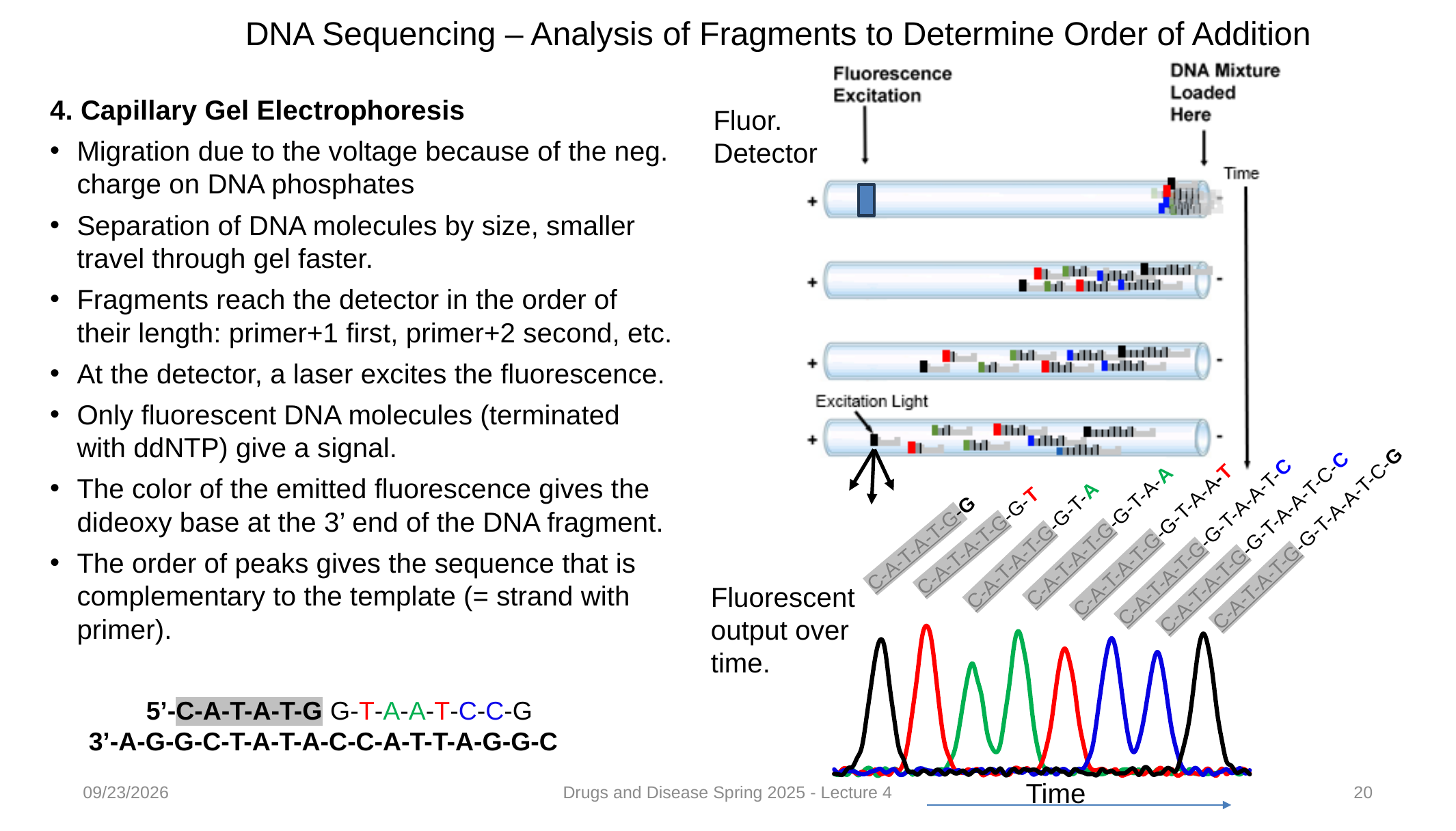
How many blue peaks are there in the fluorescent output over time chart? 2 Reading the peaks of the fluorescent output over time chart from left to right, what sequence of bases is obtained? G-T-A-A-T-C-C-G In the fluorescent output over time chart, which base do the blue peaks correspond to? C What kind of chart is the 'Fluorescent output over time' plot at the bottom right of the slide? line chart In the fluorescent output over time chart, which base does the second (red) peak correspond to? T In the fluorescent output over time chart, is the third peak (first green) taller or shorter than the fourth peak (second green)? shorter How many peaks are shown in the fluorescent output over time chart? 8 What is the label on the horizontal axis of the fluorescent output over time chart? Time In the fluorescent output over time chart, what colour is the first peak? black In the fluorescent output over time chart, which base does the last (black) peak correspond to? G